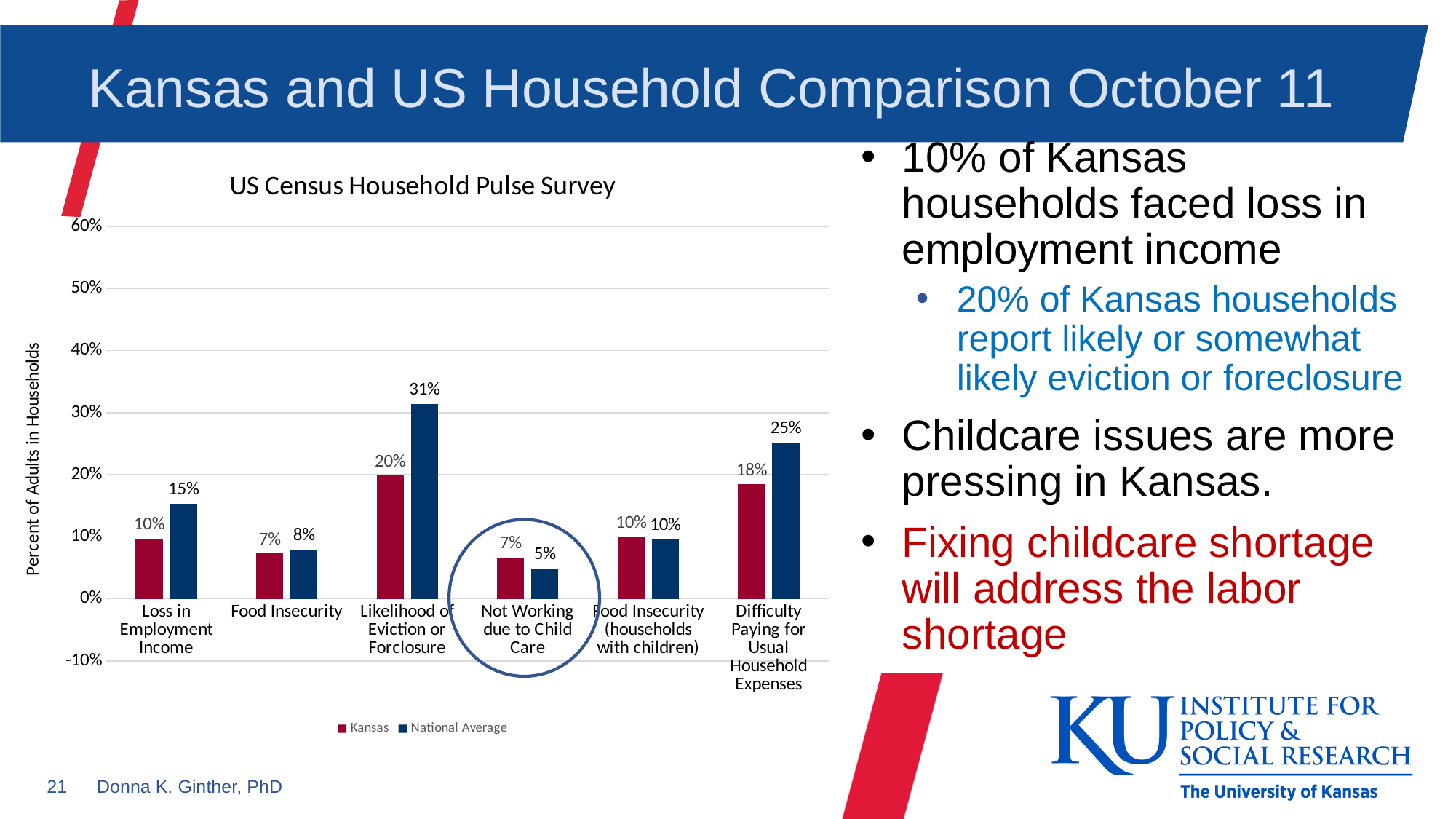
What is the title of the chart? US Census Household Pulse Survey What is the difference between the National Average and Kansas values for Loss in Employment Income? 5% How many categories are shown on the x axis of the chart? 6 What type of chart is shown on the slide? bar chart How many series does the chart legend list? 2 Which series is shown in red in the chart? Kansas Which category has the highest National Average value? Likelihood of Eviction or Forclosure What is the Kansas value for Likelihood of Eviction or Forclosure? 20% What is the National Average value for Difficulty Paying for Usual Household Expenses? 25% What is the National Average value for Not Working due to Child Care? 5% What is the difference between the National Average and Kansas values for Likelihood of Eviction or Forclosure? 11% For Not Working due to Child Care, which is larger: the Kansas value or the National Average value? Kansas